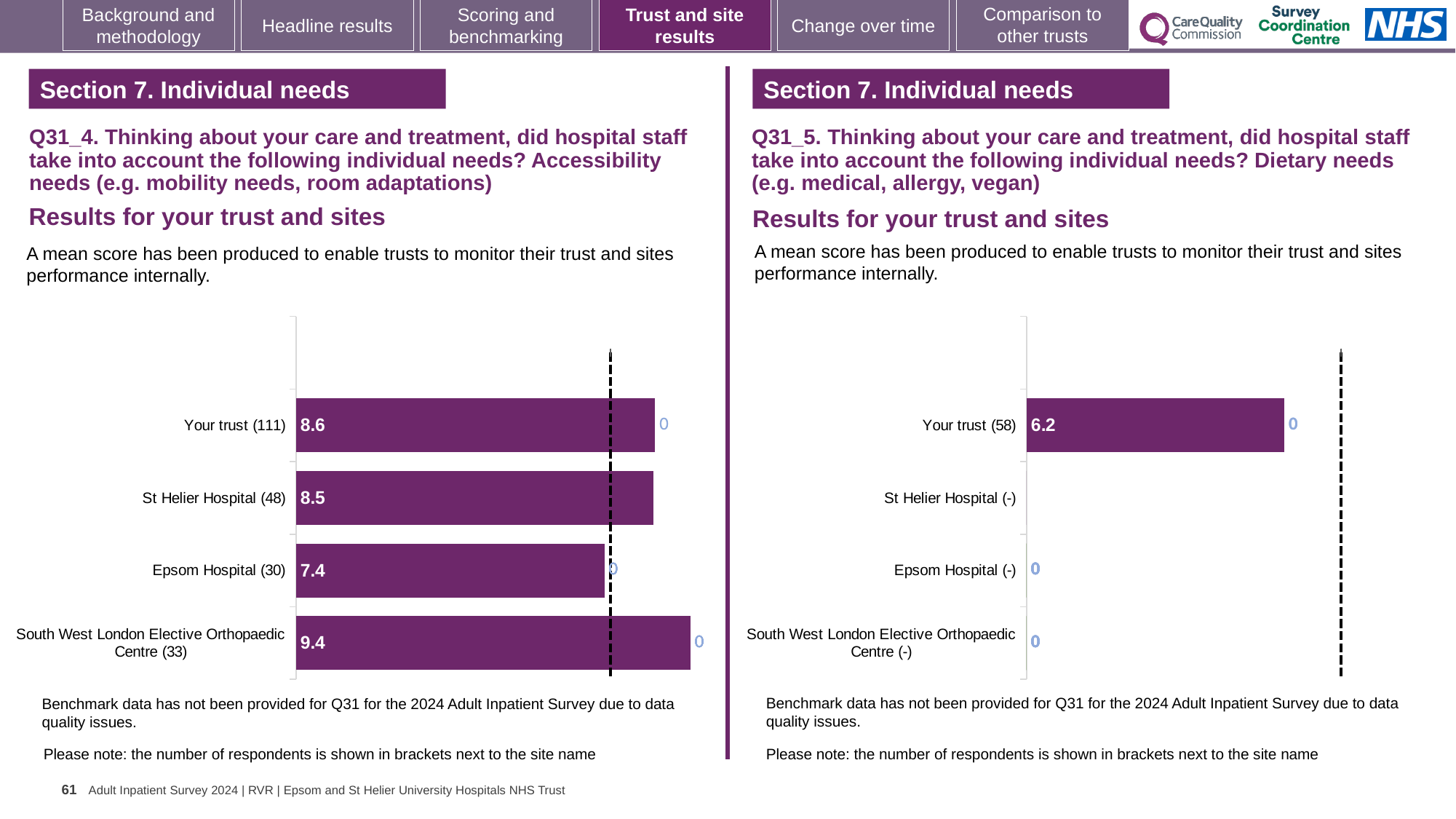
On the Q31_5 Dietary needs chart (right), how many respondents are shown for Your trust? 58 On the Q31_4 Accessibility needs chart (left), which site has the highest mean score? South West London Elective Orthopaedic Centre What type of chart is used on the left side of the slide for Q31_4? Bar chart On the Q31_4 Accessibility needs chart (left), how many respondents are shown for St Helier Hospital? 48 On the Q31_4 Accessibility needs chart (left), which has the higher score: St Helier Hospital or Epsom Hospital? St Helier Hospital On the Q31_4 Accessibility needs chart (left), what is the mean score for Your trust? 8.6 On the Q31_4 Accessibility needs chart (left), what is the mean score for South West London Elective Orthopaedic Centre? 9.4 On the Q31_4 Accessibility needs chart (left), what is the mean score for Epsom Hospital? 7.4 On the Q31_4 Accessibility needs chart (left), how many categories are plotted? 4 On the Q31_4 Accessibility needs chart (left), which site has the lowest mean score? Epsom Hospital On the Q31_5 Dietary needs chart (right), what is the mean score for Your trust? 6.2 On the Q31_4 Accessibility needs chart (left), what is the difference between the scores for South West London Elective Orthopaedic Centre and Epsom Hospital? 2.0